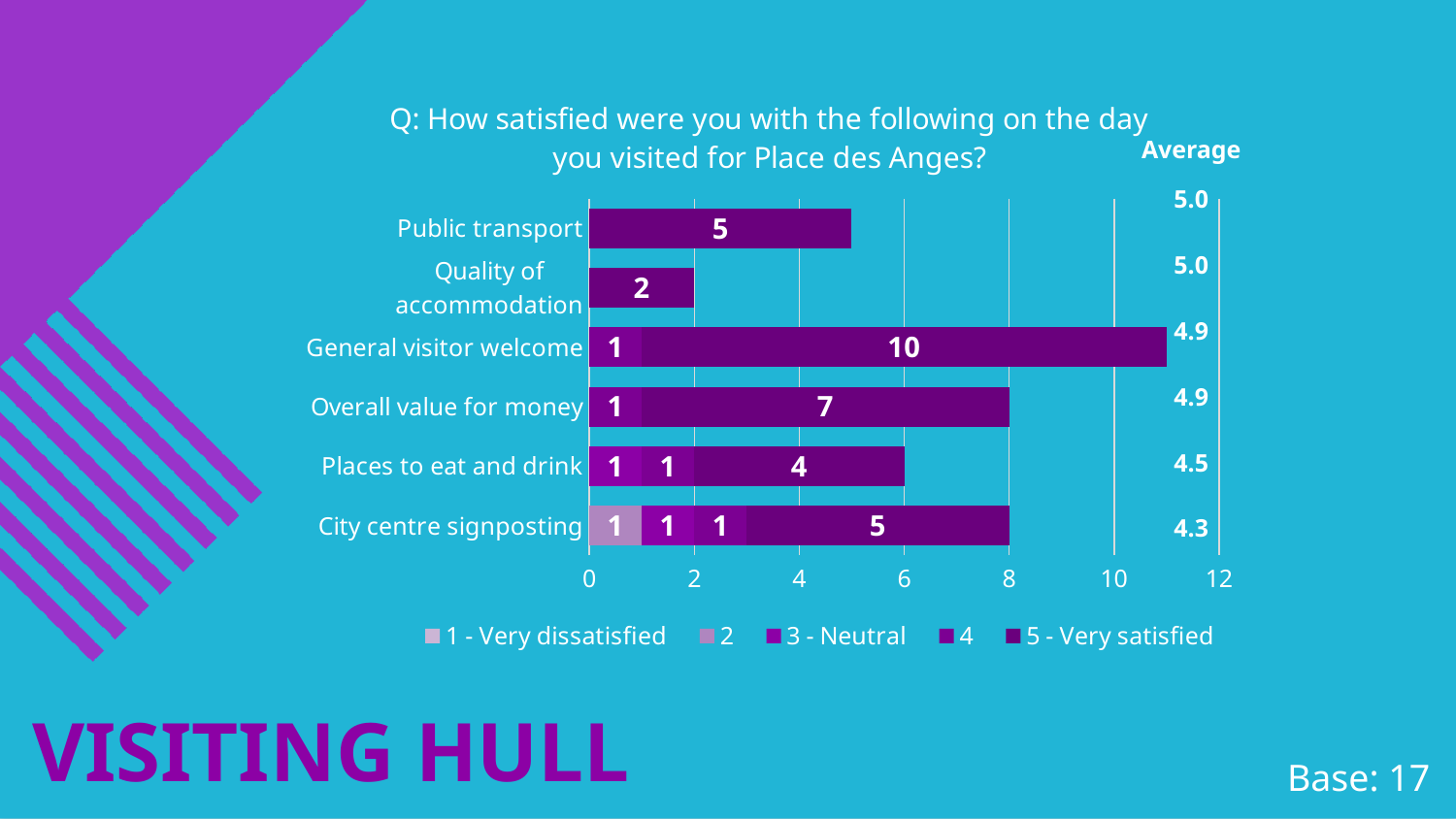
How many series does the legend list? 5 What is the difference between the Average for Public transport and the Average for City centre signposting? 0.7 Which has the larger stacked bar total, Overall value for money or Places to eat and drink? Overall value for money What kind of chart is shown on the slide? bar chart What is the Average shown for Public transport? 5.0 What is the total of the stacked bar for City centre signposting? 8 How many categories are plotted on the chart? 6 Which category has the shortest bar overall? Quality of accommodation What is the value of the largest segment in the General visitor welcome bar? 10 What is the total of the stacked bar for General visitor welcome? 11 Which category has the longest bar overall? General visitor welcome What is the Average shown for City centre signposting? 4.3